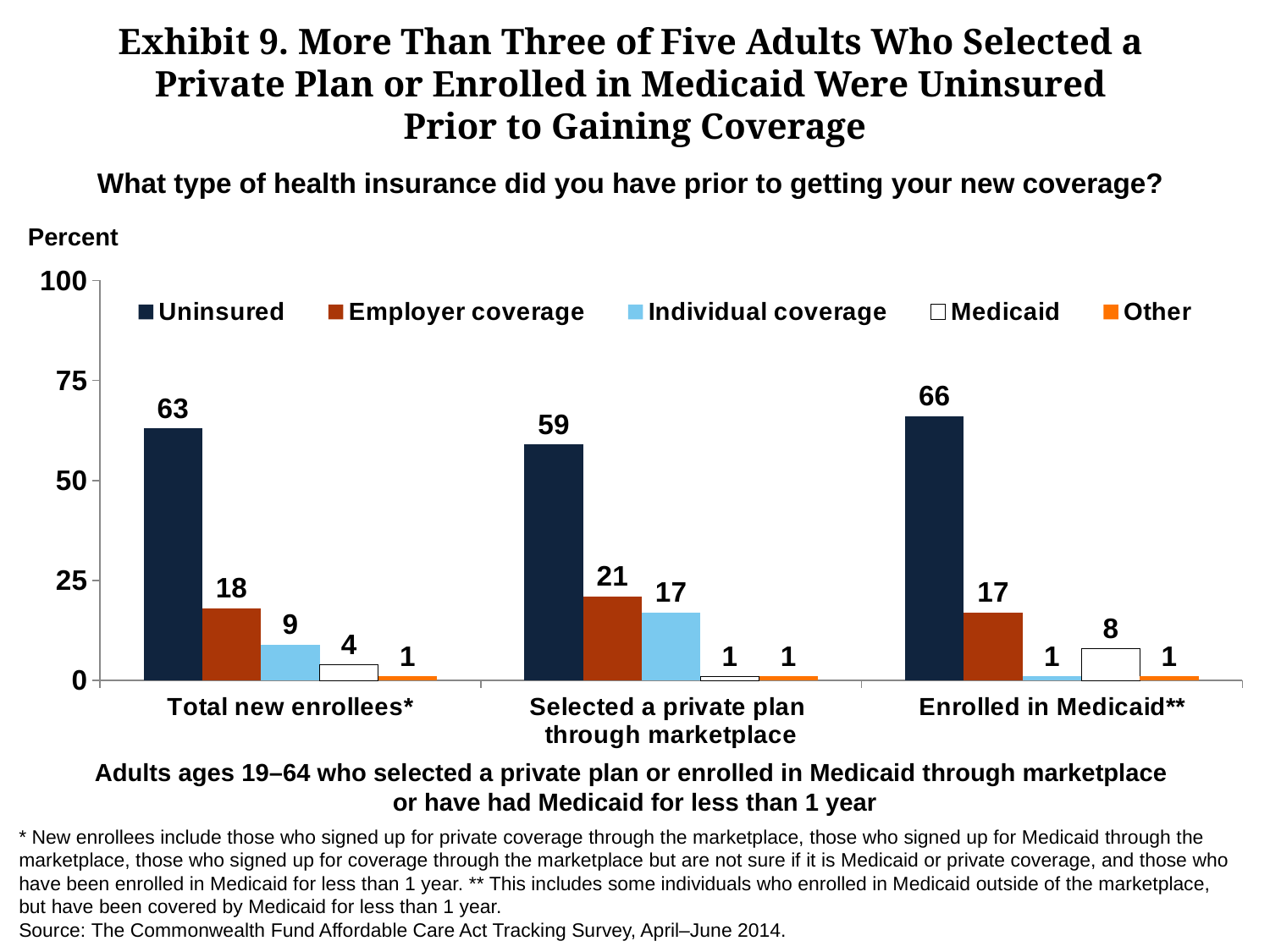
Which category has the highest Uninsured value? Enrolled in Medicaid** Which category has the lowest Uninsured value? Selected a private plan through marketplace What is the value for Individual coverage in the Selected a private plan through marketplace category? 17 What is the difference between the Uninsured value for Enrolled in Medicaid** and the Uninsured value for Selected a private plan through marketplace? 7 What is the value for Uninsured in the Total new enrollees* category? 63 Is the Uninsured value for Total new enrollees* greater or less than 50? greater Which is larger: Employer coverage for Total new enrollees* or Employer coverage for Selected a private plan through marketplace? Selected a private plan through marketplace What kind of chart is shown on the slide? bar chart How many categories are shown on the x axis? 3 How many series does the legend list? 5 What is the value for Medicaid in the Enrolled in Medicaid** category? 8 What is the label on the y axis? Percent